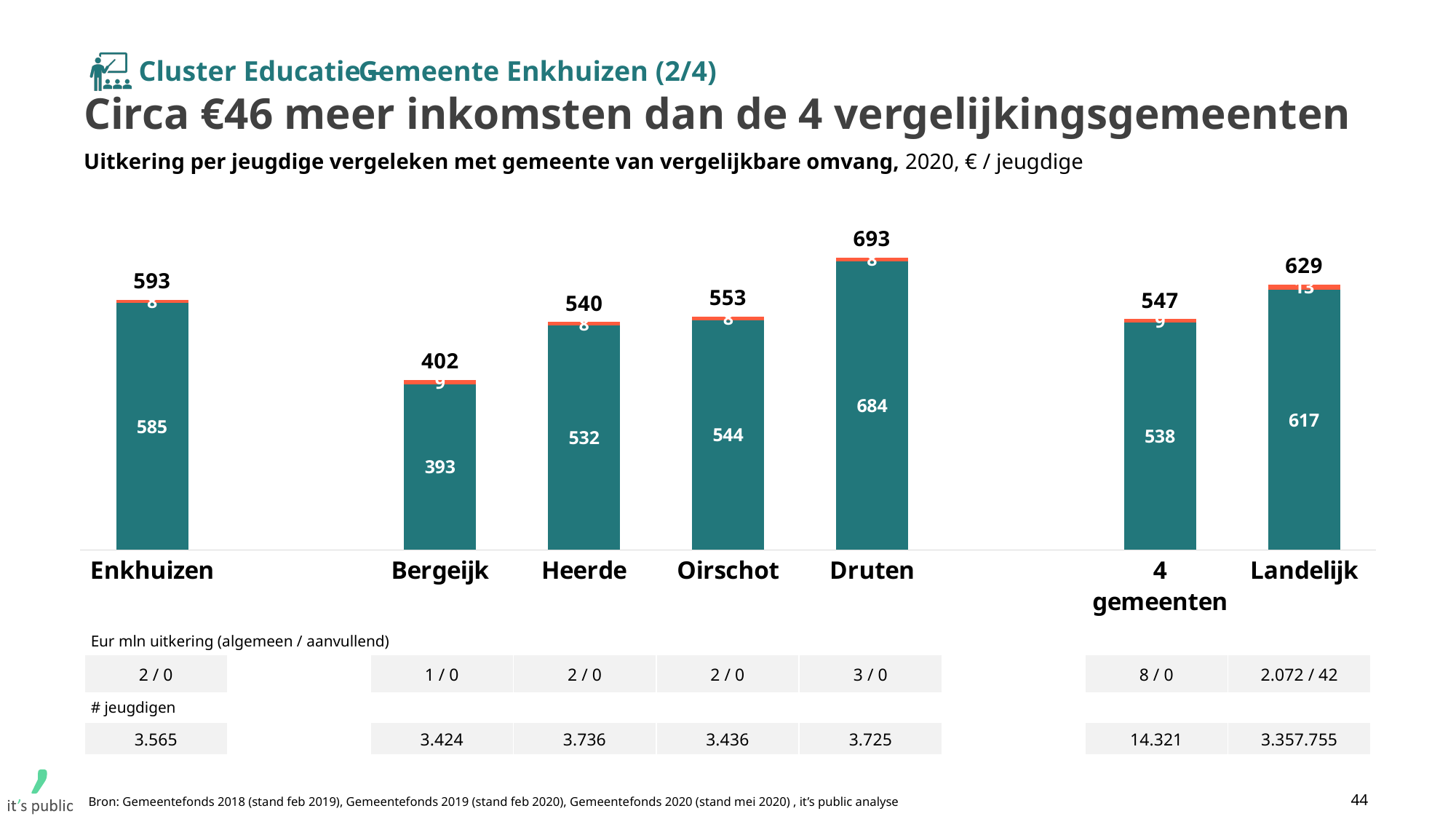
What is the value of the teal (lower) segment for Bergeijk? 393 What is the total value shown above the bar for Landelijk? 629 What is the value of the teal (lower) segment for Druten? 684 What is the total value shown above the bar for Enkhuizen? 593 Which has a larger total value, Heerde or Oirschot? Oirschot What kind of chart is shown on the slide? Stacked bar chart What is the difference between the total for Enkhuizen and the total for 4 gemeenten? 46 How many categories (bars) are shown in the chart? 7 Which category has the lowest total value? Bergeijk Which category has the highest total value? Druten What is the total value shown above the bar for 4 gemeenten? 547 What is the difference between the teal segment values for Landelijk and 4 gemeenten? 79